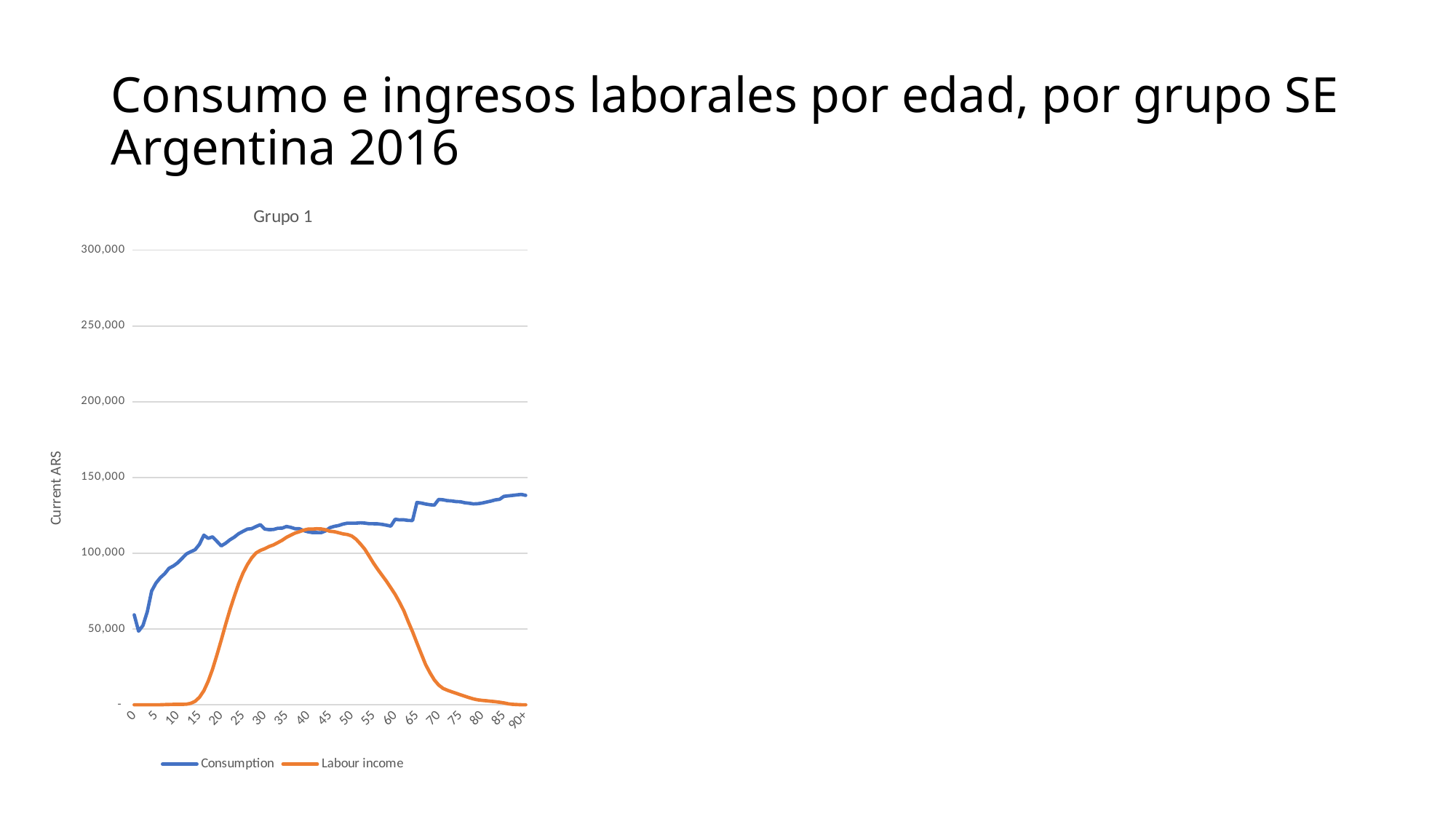
Does Consumption generally rise or fall from age 0 to age 90+? rise Is the value of Labour income at age 40 greater or less than 100,000? greater Does Labour income rise or fall between age 50 and age 90+? fall What kind of chart is shown on the slide? line chart What is the title of the chart? Grupo 1 Is the value of Consumption at age 90+ greater or less than 150,000? less How many series does the legend of the chart list? 2 Is the value of Labour income at age 10 greater or less than 50,000? less At age 70, which series has the higher value, Consumption or Labour income? Consumption What are the two series named in the chart legend? Consumption and Labour income At age 20, which series has the higher value, Consumption or Labour income? Consumption